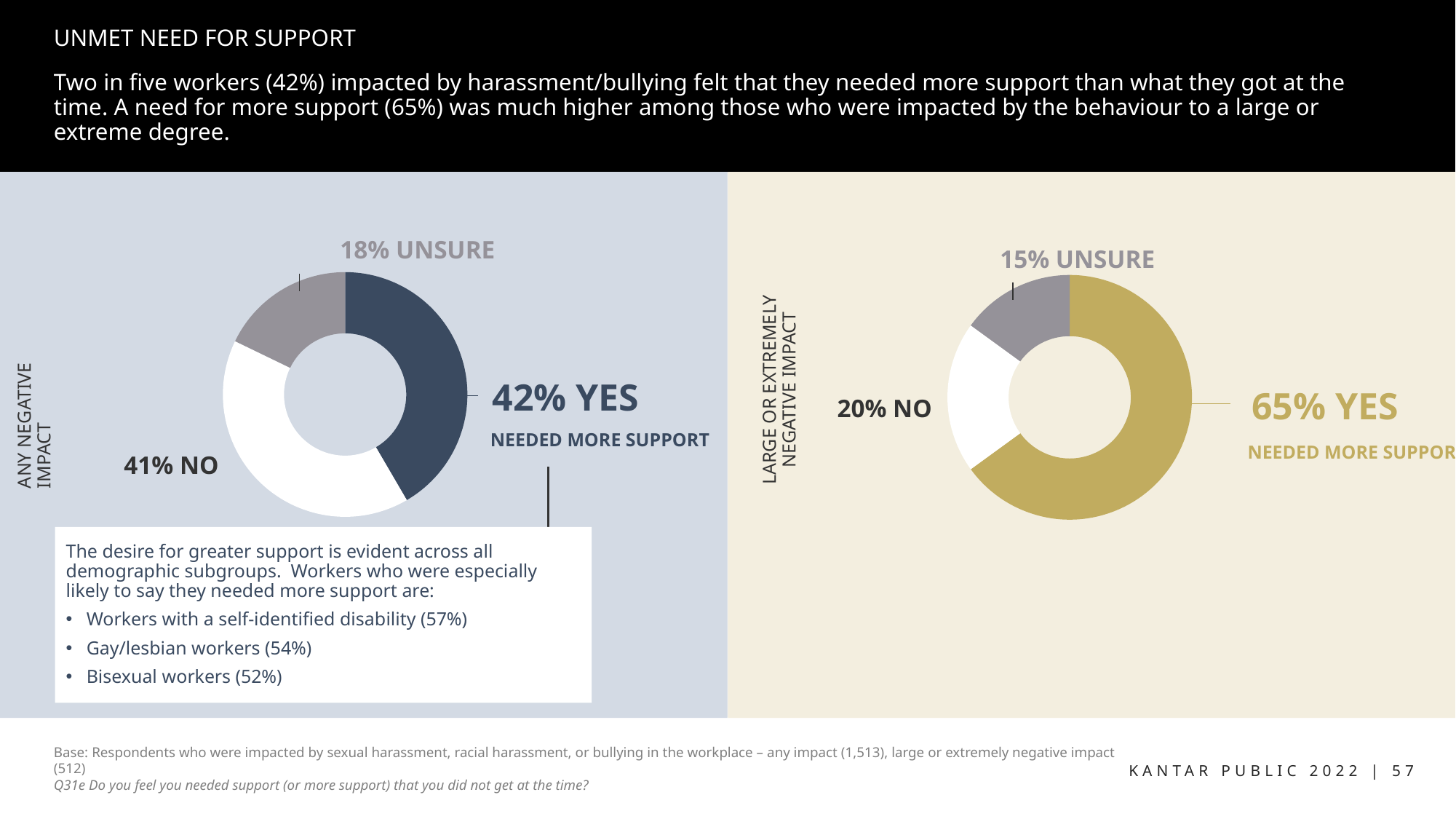
What is the difference between the Yes share in the right chart (large or extremely negative impact) and the Yes share in the left chart (any negative impact)? 23 percentage points In the 'Large or extremely negative impact' chart on the right, what percentage said Yes, they needed more support? 65% In the 'Any negative impact' chart on the left, what percentage of workers said they needed more support (Yes)? 42% What type of chart is used on this slide? Donut (pie) chart In the 'Large or extremely negative impact' chart on the right, which response has the largest share? Yes In the 'Large or extremely negative impact' chart on the right, what is the difference between the Yes and No shares? 45 percentage points In the 'Large or extremely negative impact' chart on the right, which response has the smallest share? Unsure In the 'Large or extremely negative impact' chart on the right, what percentage answered No? 20% How many response categories does each donut chart on the slide show? 3 In the 'Any negative impact' chart on the left, what percentage answered No? 41% In the 'Any negative impact' chart on the left, which response has the smallest share? Unsure In the 'Any negative impact' chart on the left, what percentage were Unsure? 18%